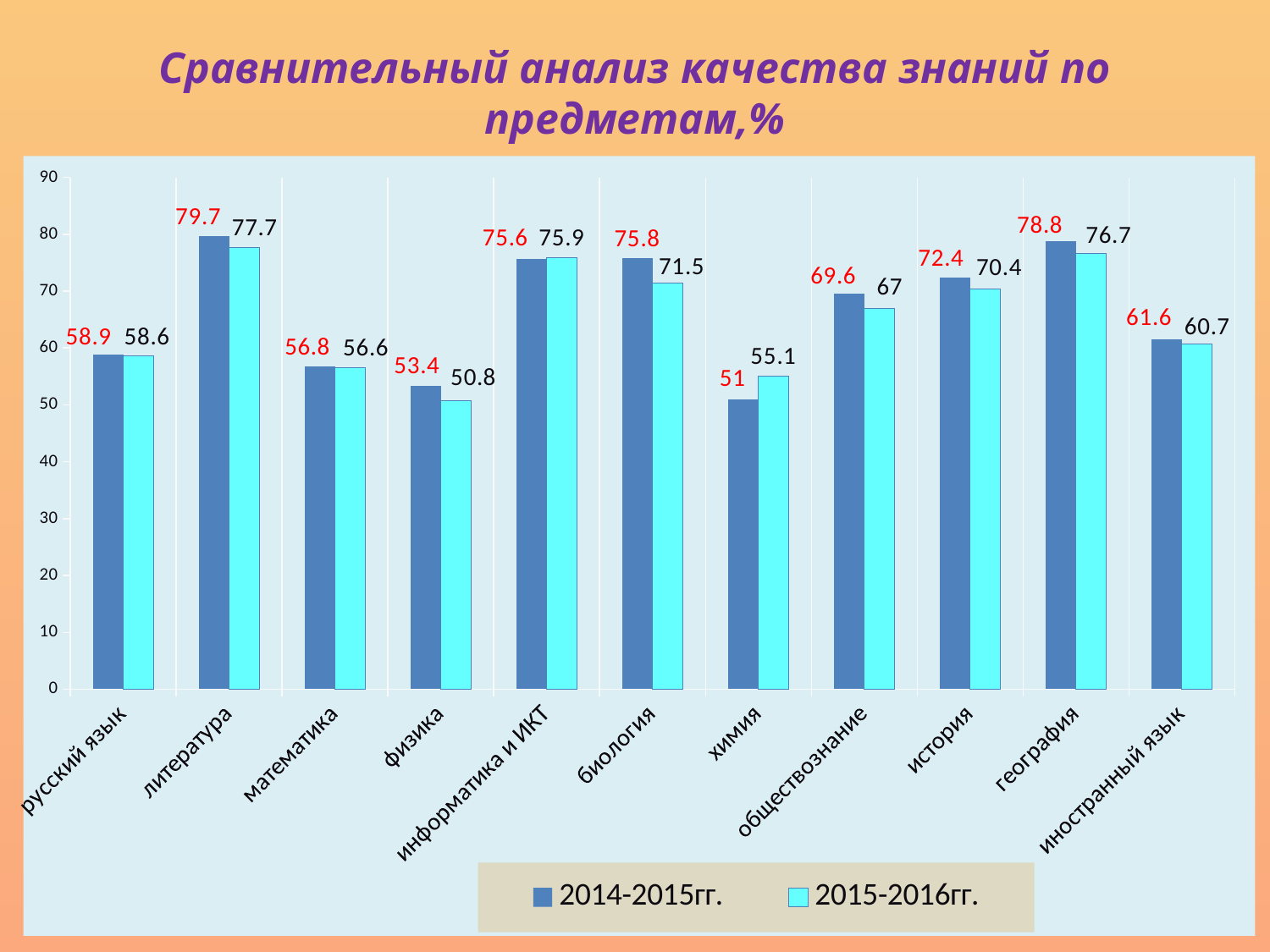
What type of chart is shown on the slide? bar chart Which subject has the highest value in the 2014-2015гг. series? литература What is the value for обществознание in the 2015-2016гг. series? 67 How many subject categories are shown on the x axis? 11 What is the difference between the 2014-2015гг. and 2015-2016гг. values for биология? 4.3 What is the value for литература in the 2014-2015гг. series? 79.7 Is the 2014-2015гг. value for география greater or less than 70? greater How many series does the legend list? 2 What is the title of the chart on the slide? Сравнительный анализ качества знаний по предметам,% For химия, which series has the larger value: 2014-2015гг. or 2015-2016гг.? 2015-2016гг. Which subject has the lowest value in the 2015-2016гг. series? физика What is the value for химия in the 2015-2016гг. series? 55.1